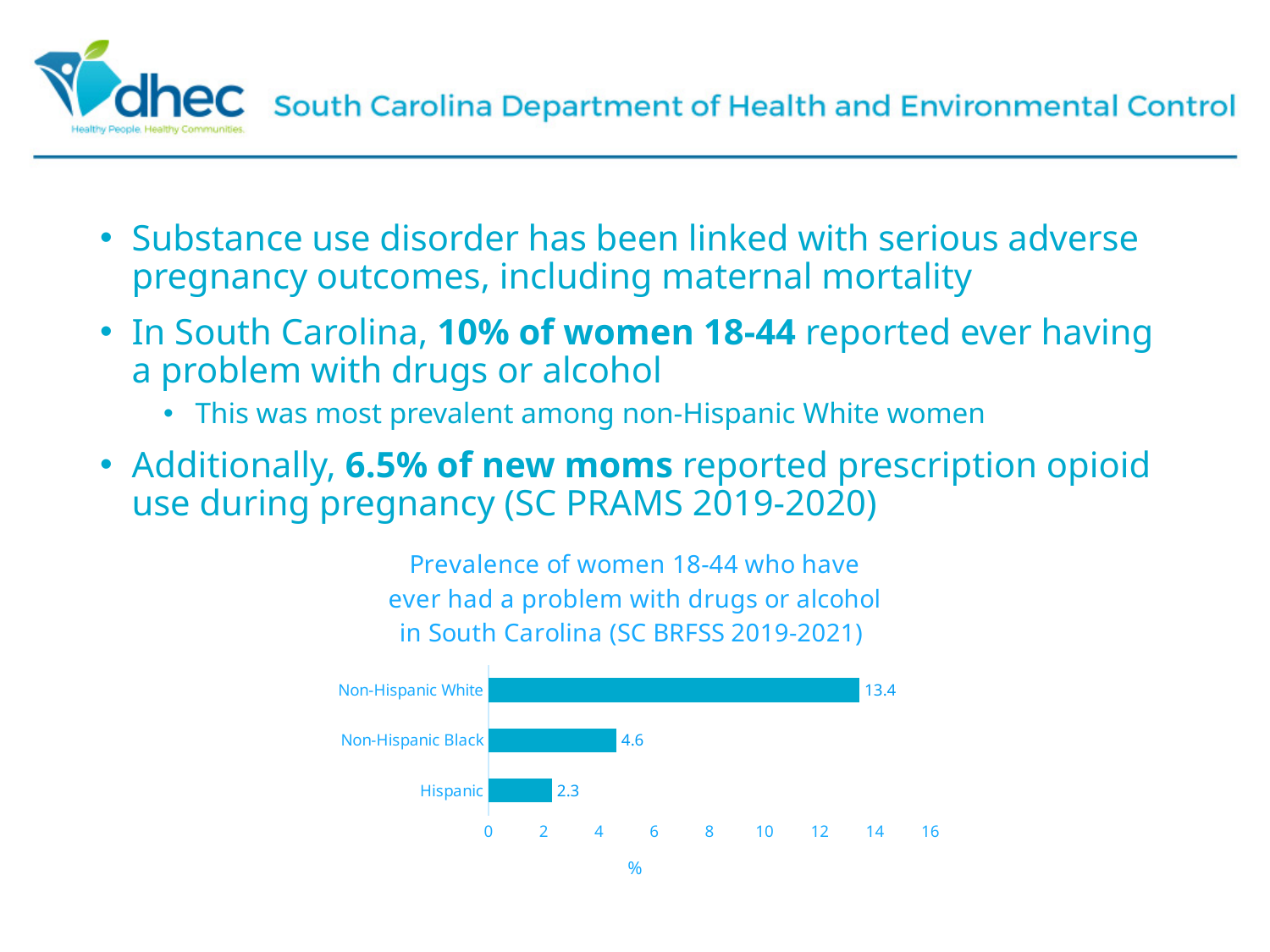
What is the difference between the values for Non-Hispanic White and Non-Hispanic Black? 8.8 What unit is labelled on the horizontal axis of the chart? % How many categories are shown in the chart? 3 Which category has the lowest value in the chart? Hispanic What is the difference between the values for Non-Hispanic Black and Hispanic? 2.3 Which is larger, the value for Non-Hispanic Black or the value for Hispanic? Non-Hispanic Black What is the value for Non-Hispanic Black in the chart? 4.6 Is the value for Non-Hispanic White greater or less than 12? greater What is the value for Non-Hispanic White in the chart? 13.4 What is the value for Hispanic in the chart? 2.3 What kind of chart is shown on the slide? bar chart Which category has the highest value in the chart? Non-Hispanic White